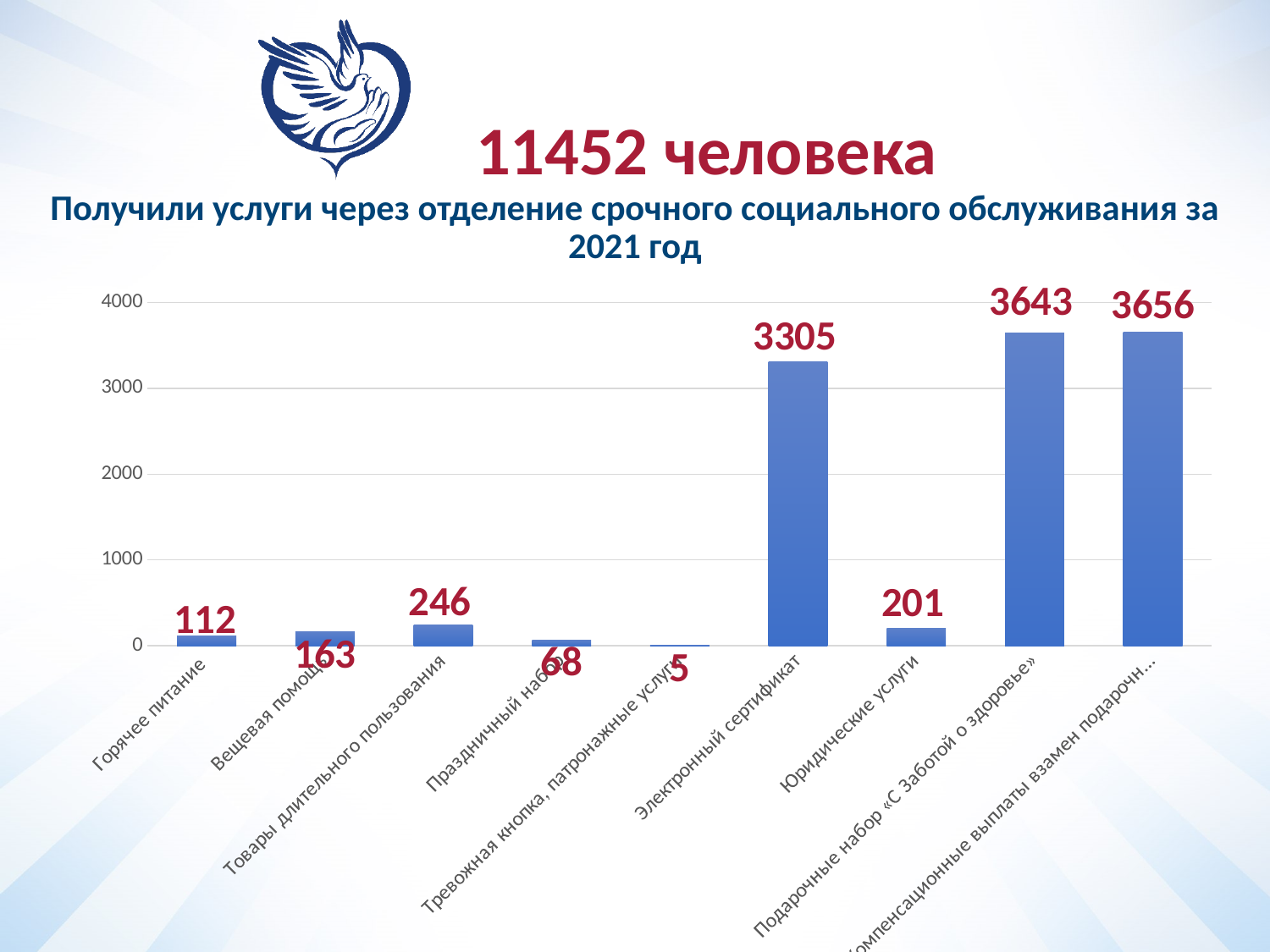
What kind of chart is shown on the slide? bar chart Is the value for Электронный сертификат greater or less than 3000? greater What total number of people is stated in the heading above the chart? 11452 человека What is the value for Горячее питание? 112 What is the difference between the values for Подарочные набор «С Заботой о здоровье» and Электронный сертификат? 338 Which category has the lowest value? Тревожная кнопка, патронажные услуги Which category has the highest value? Компенсационные выплаты взамен подарочн... (the rightmost bar) What is the value for Юридические услуги? 201 What is the value for Товары длительного пользования? 246 What is the value for Электронный сертификат? 3305 Which is larger: the value for Вещевая помощь or the value for Праздничный набор? Вещевая помощь How many categories are plotted in the chart? 9